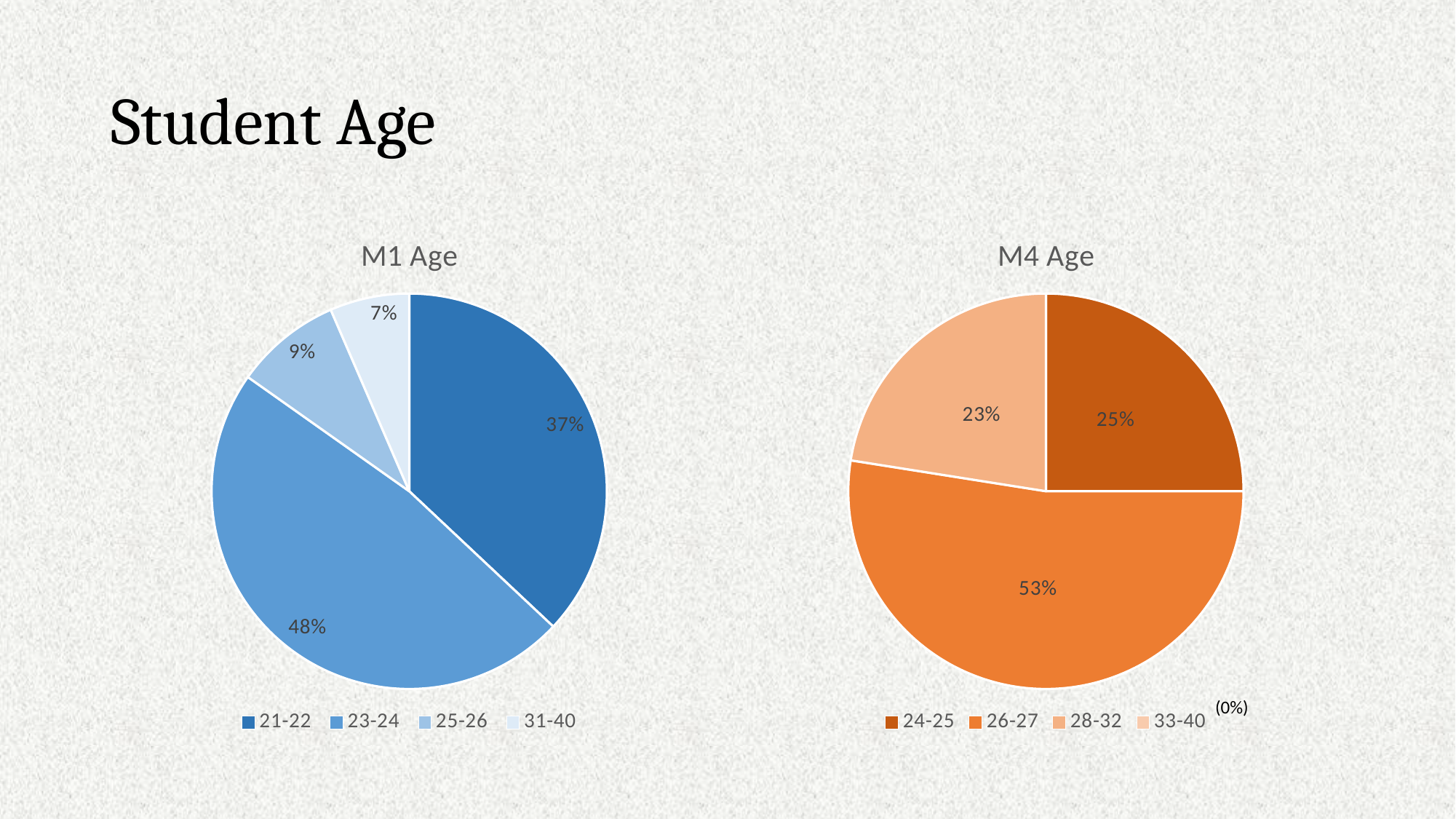
In the M4 Age chart, what percentage of students are aged 28-32? 23% In the M1 Age chart, which age group has the smallest share? 31-40 In the M1 Age chart, which age group has the largest share? 23-24 In the M1 Age chart, what percentage of students are aged 31-40? 7% In the M4 Age chart, what percentage of students are aged 26-27? 53% In the M1 Age chart, what percentage of students are aged 23-24? 48% How many age groups does the legend of the M1 Age chart list? 4 In the M4 Age chart, which age group has the largest share? 26-27 In the M4 Age chart, what is the difference in percentage points between the 26-27 and 24-25 groups? 28 What type of chart is the M4 Age chart? Pie chart In the M4 Age chart, which group has a larger share, 24-25 or 28-32? 24-25 In the M1 Age chart, what is the difference in percentage points between the 23-24 and 21-22 groups? 11